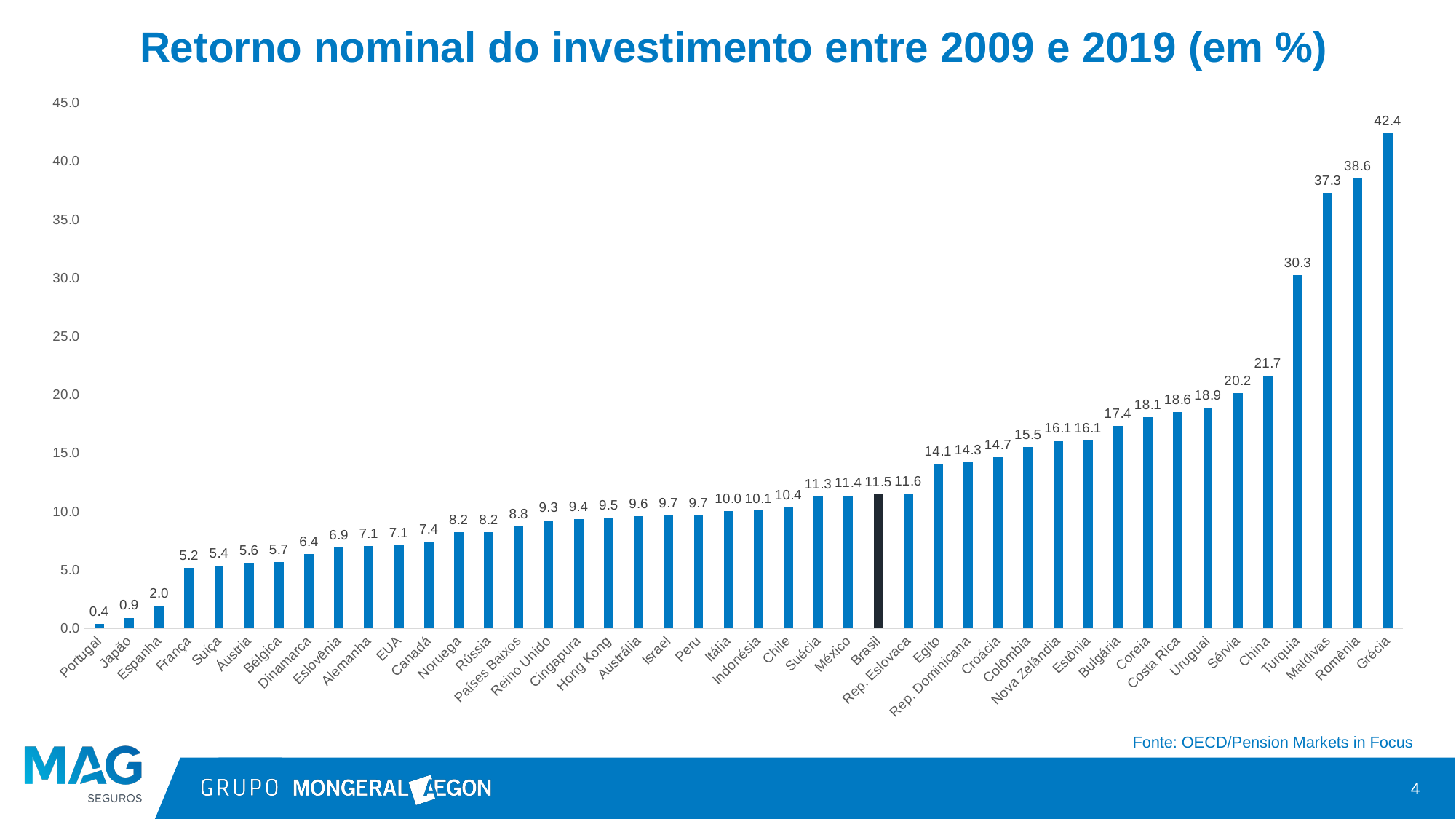
Which country has the lowest nominal investment return in the chart? Portugal What is the difference between the values for Brasil and Portugal? 11.1 How many countries are shown in the chart? 44 What type of chart is shown on the slide? bar chart What is the nominal investment return shown for Brasil? 11.5 What value is shown for Alemanha? 7.1 Do the values rise or fall from left to right along the x axis? rise What is the difference between the values for Grécia and Romênia? 3.8 Which has a higher value, Turquia or China? Turquia What value is shown for Grécia? 42.4 Which has a higher value, Chile or Egito? Egito Which country has the highest nominal investment return in the chart? Grécia